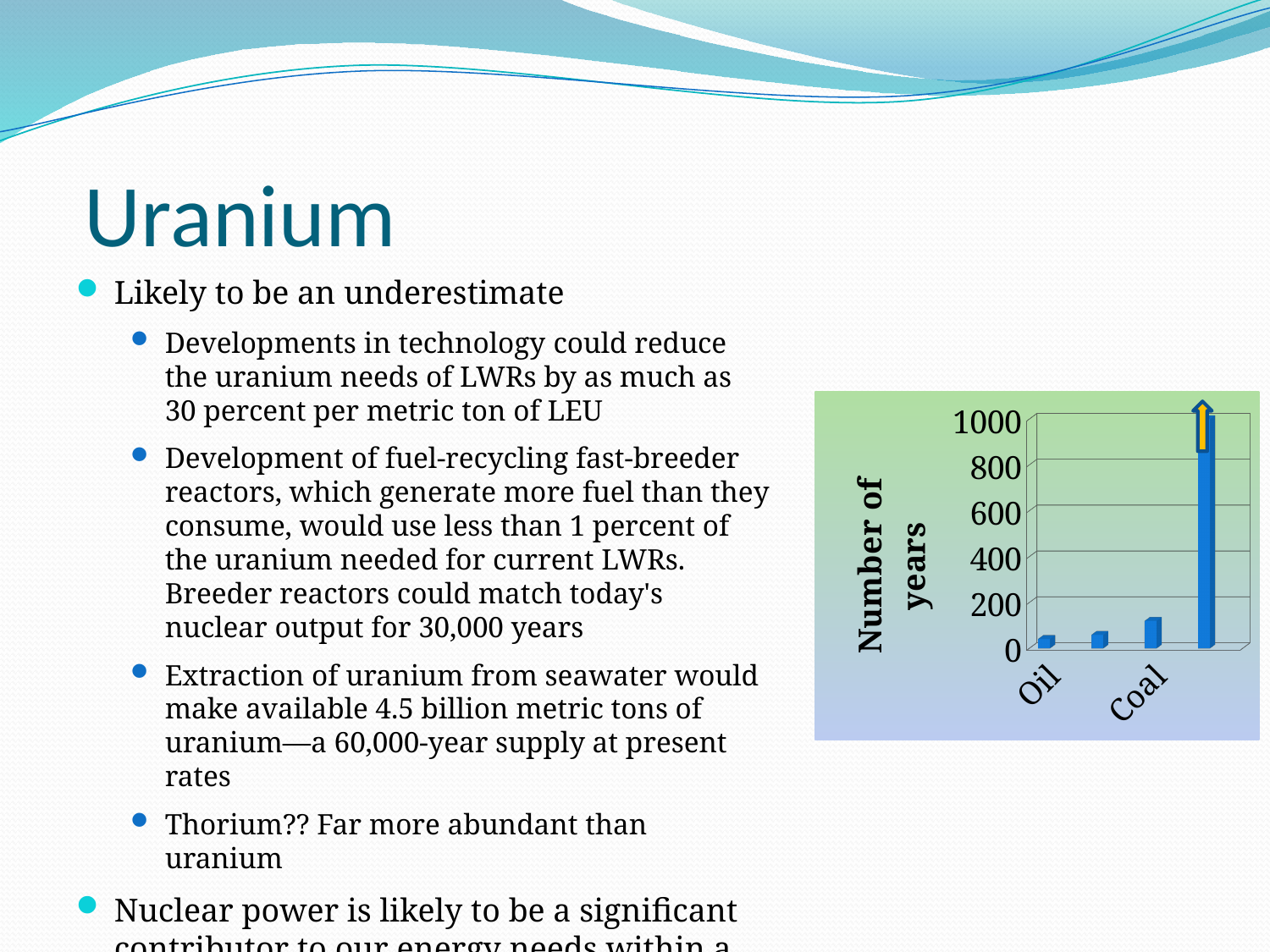
What kind of chart is shown on the slide? bar chart How many bars are plotted in the chart? 4 Which is larger, the value for Oil or the value for Coal? Coal Is the value for Oil greater or less than 400? less Is the value for Coal greater or less than 200? less What is the highest tick value shown on the vertical axis? 1000 Is the tallest bar in the chart greater or less than 800? greater What is the label on the vertical axis of the chart? Number of years